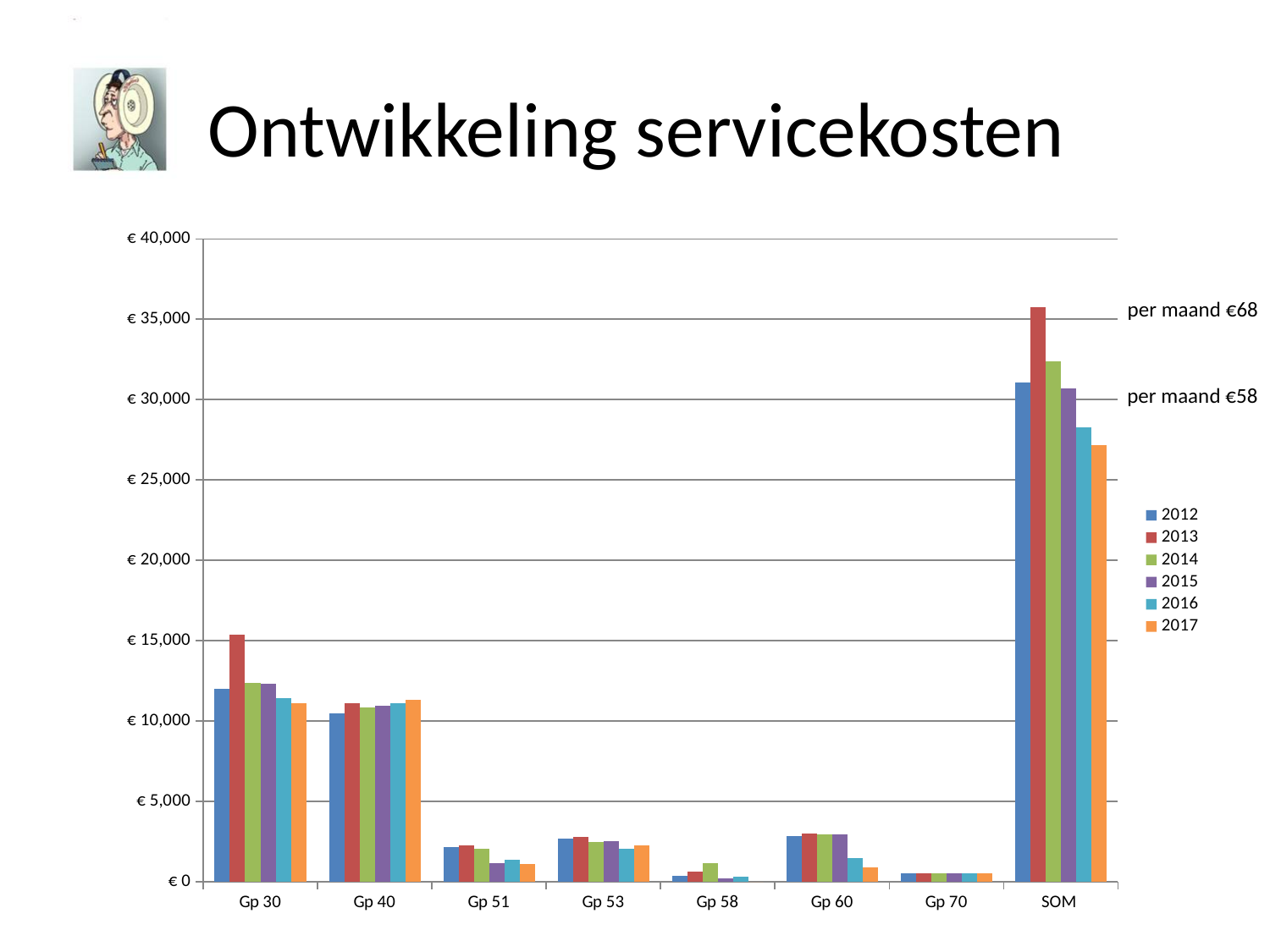
For the SOM category, which year has the highest value? 2013 How many series does the legend list? 6 For the Gp 30 category, which year has the highest value? 2013 How many categories are shown along the x axis? 8 Is the value for Gp 51 in 2012 greater or less than 5,000? less Which is larger in 2012: the value for Gp 30 or the value for Gp 40? Gp 30 Which category has the highest bars overall? SOM For the SOM category, which year has the lowest value? 2017 Is the value for Gp 30 in 2012 greater or less than 10,000? greater For the SOM category, do the values rise or fall from 2014 to 2017? fall Is the value for SOM in 2017 greater or less than 30,000? less What kind of chart is shown on the slide? bar chart